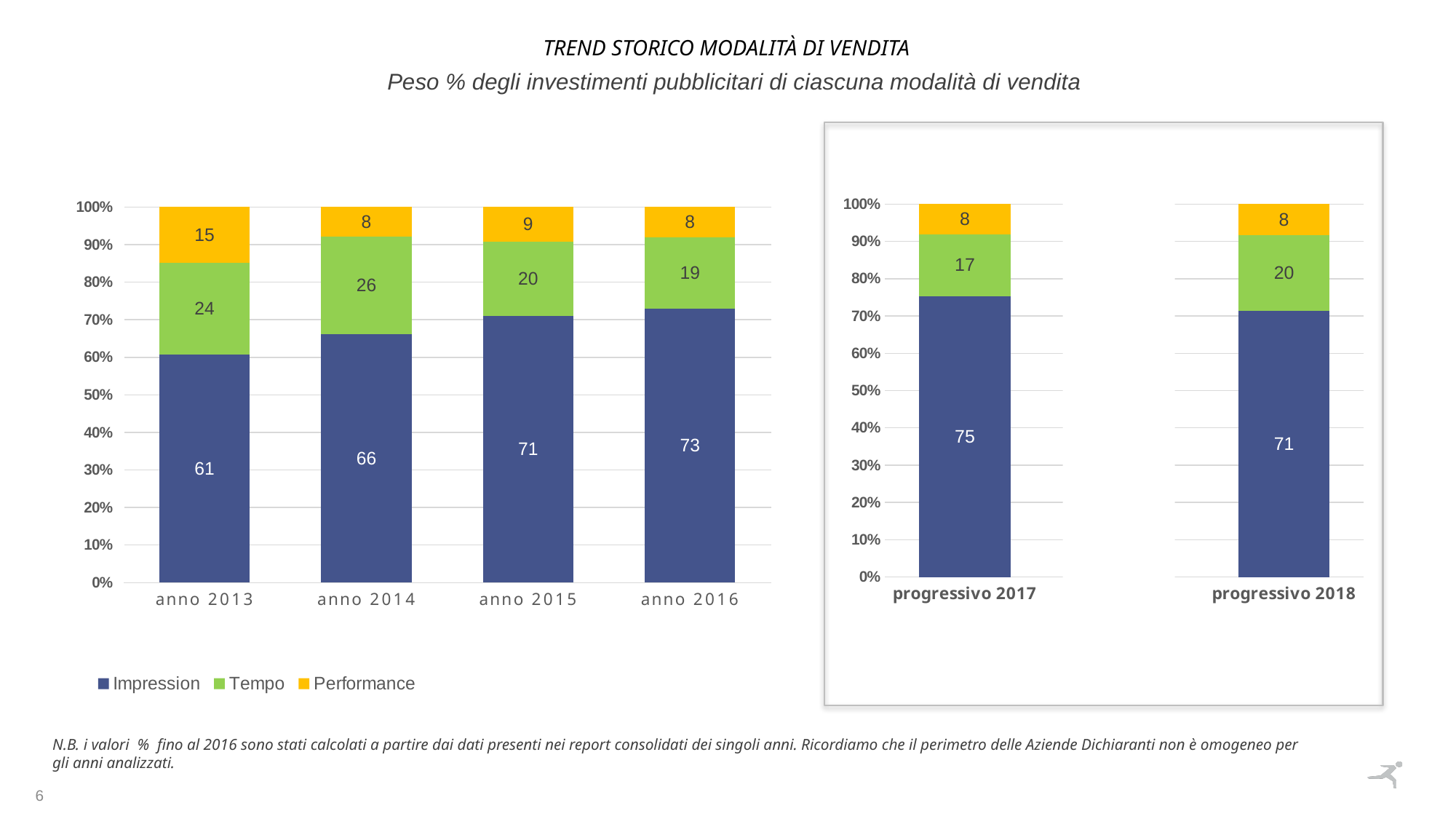
In the left chart, what is the Performance value for anno 2015? 9 In the left chart, what is the Impression value for anno 2013? 61 In the right chart, what is the Tempo value for progressivo 2018? 20 In the left chart, which year has the lowest Performance value? anno 2014 and anno 2016 How many categories are shown on the x axis of the left chart? 4 In the right chart, what is the Impression value for progressivo 2017? 75 In the left chart, what is the difference between the Impression values for anno 2016 and anno 2013? 12 What kind of chart is the right chart? stacked bar chart In the left chart, what is the Tempo value for anno 2014? 26 In the right chart, which has the larger Impression value, progressivo 2017 or progressivo 2018? progressivo 2017 In the left chart, which year has the highest Impression value? anno 2016 How many series does the legend of the left chart list? 3